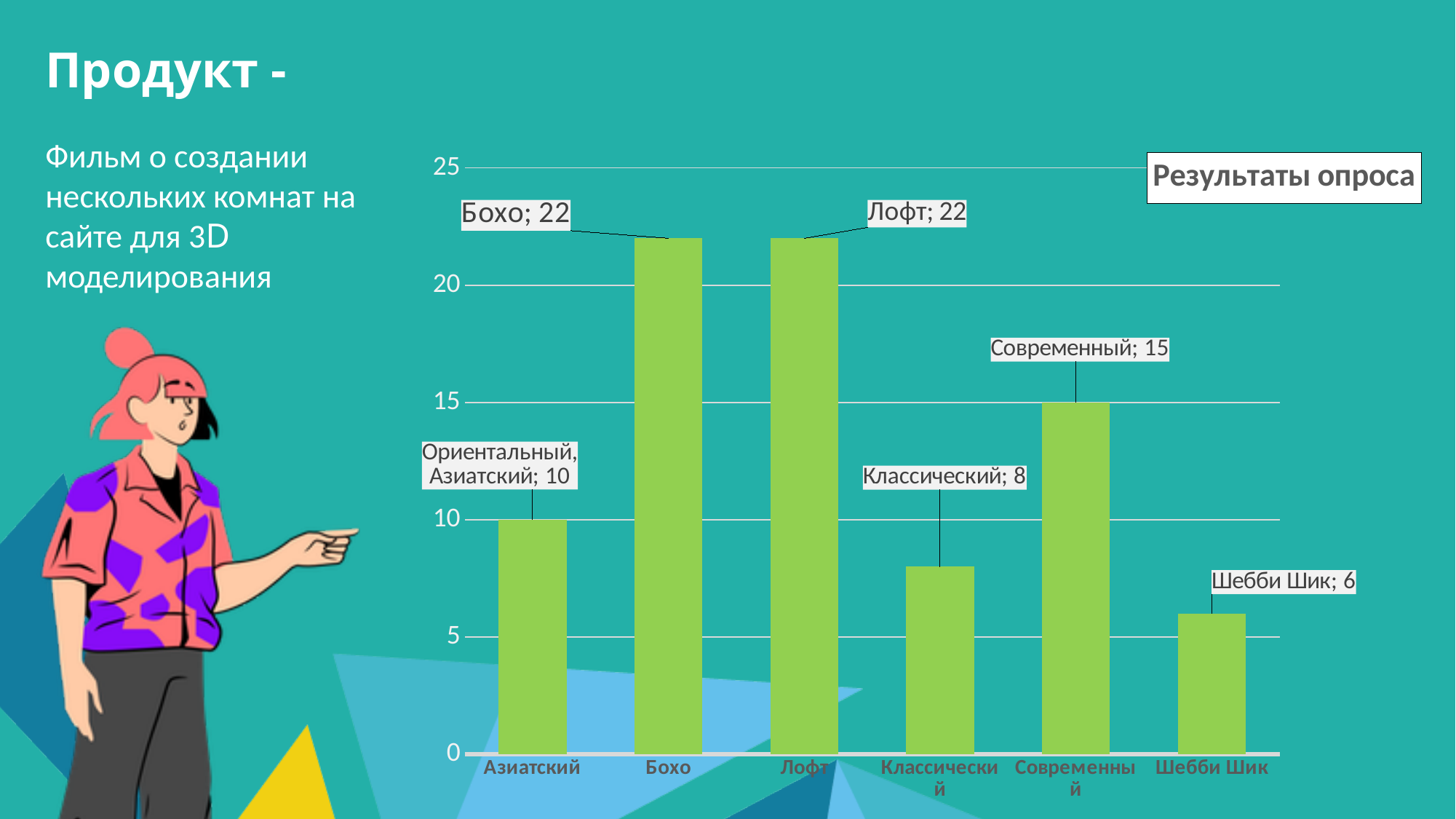
Which is larger, the value for Современный or the value for Классический? Современный What kind of chart is shown on the slide? bar chart Is the value for Бохо greater or less than 20? greater What value is shown for Современный in the chart? 15 What is the difference between the values for Азиатский and Шебби Шик? 4 What value is shown for Бохо in the chart? 22 How many categories are shown on the x axis of the chart? 6 Which category has the lowest value in the chart? Шебби Шик What is the difference between the values for Лофт and Современный? 7 What value is shown for Классический in the chart? 8 What is the title of the chart? Результаты опроса What value is shown for Шебби Шик in the chart? 6